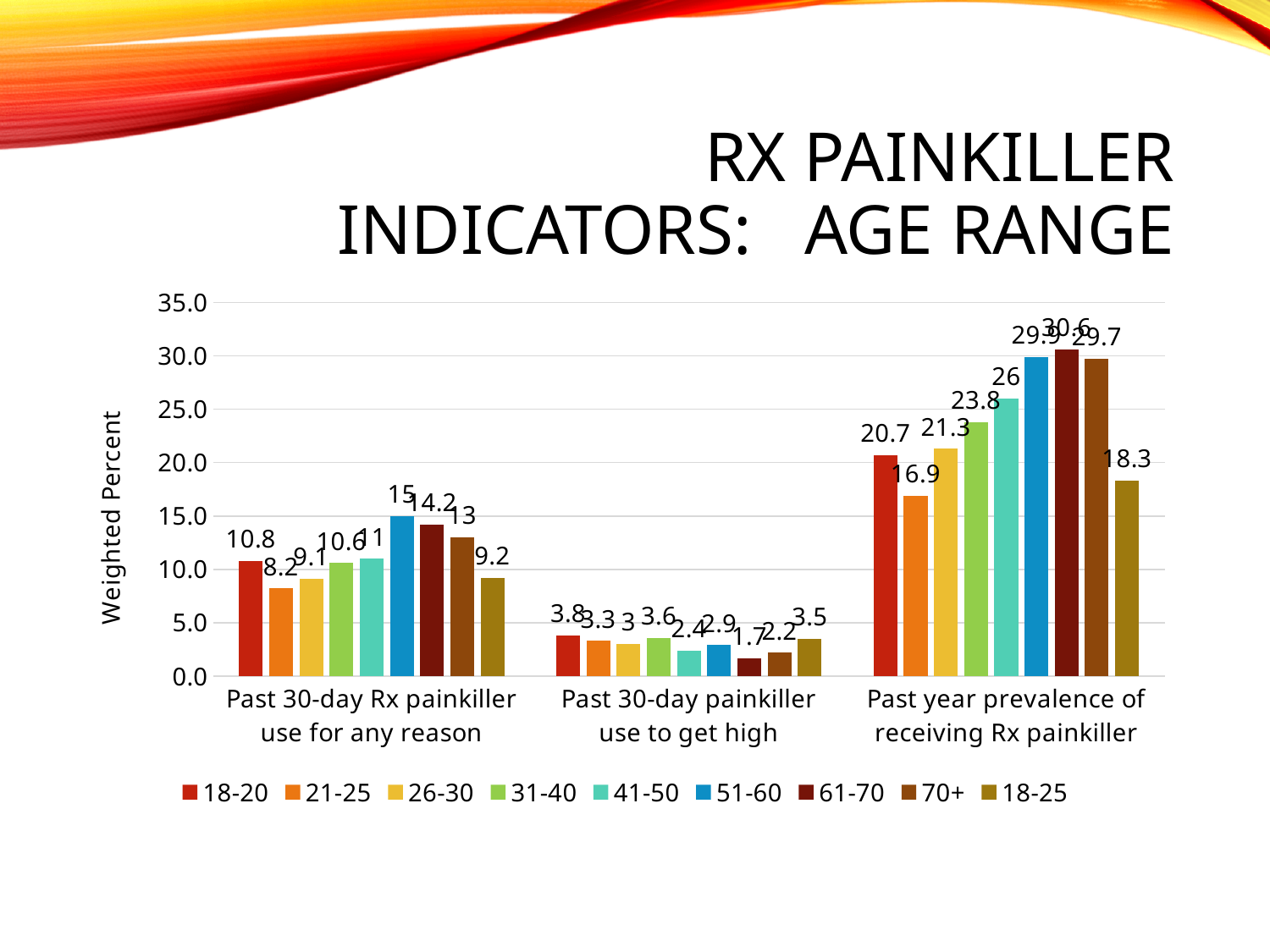
Which age group has the highest value for past 30-day Rx painkiller use for any reason? 51-60 Is the value for the 41-50 age group for past year prevalence of receiving Rx painkiller greater or less than 25.0? greater For past year prevalence of receiving Rx painkiller, which is larger: the 18-25 value or the 21-25 value? 18-25 How many indicator categories are shown on the x axis? 3 Which age group has the lowest value for past 30-day painkiller use to get high? 61-70 How many age-range series does the legend list? 9 What is the weighted percent for the 18-20 age group for past 30-day Rx painkiller use for any reason? 10.8 What is the weighted percent for the 61-70 age group for past year prevalence of receiving Rx painkiller? 30.6 What is the weighted percent for the 61-70 age group for past 30-day painkiller use to get high? 1.7 What kind of chart is shown on the slide? bar chart What is the difference between the 18-20 and 21-25 values for past year prevalence of receiving Rx painkiller? 3.8 What is the weighted percent for the 18-25 age group for past 30-day Rx painkiller use for any reason? 9.2